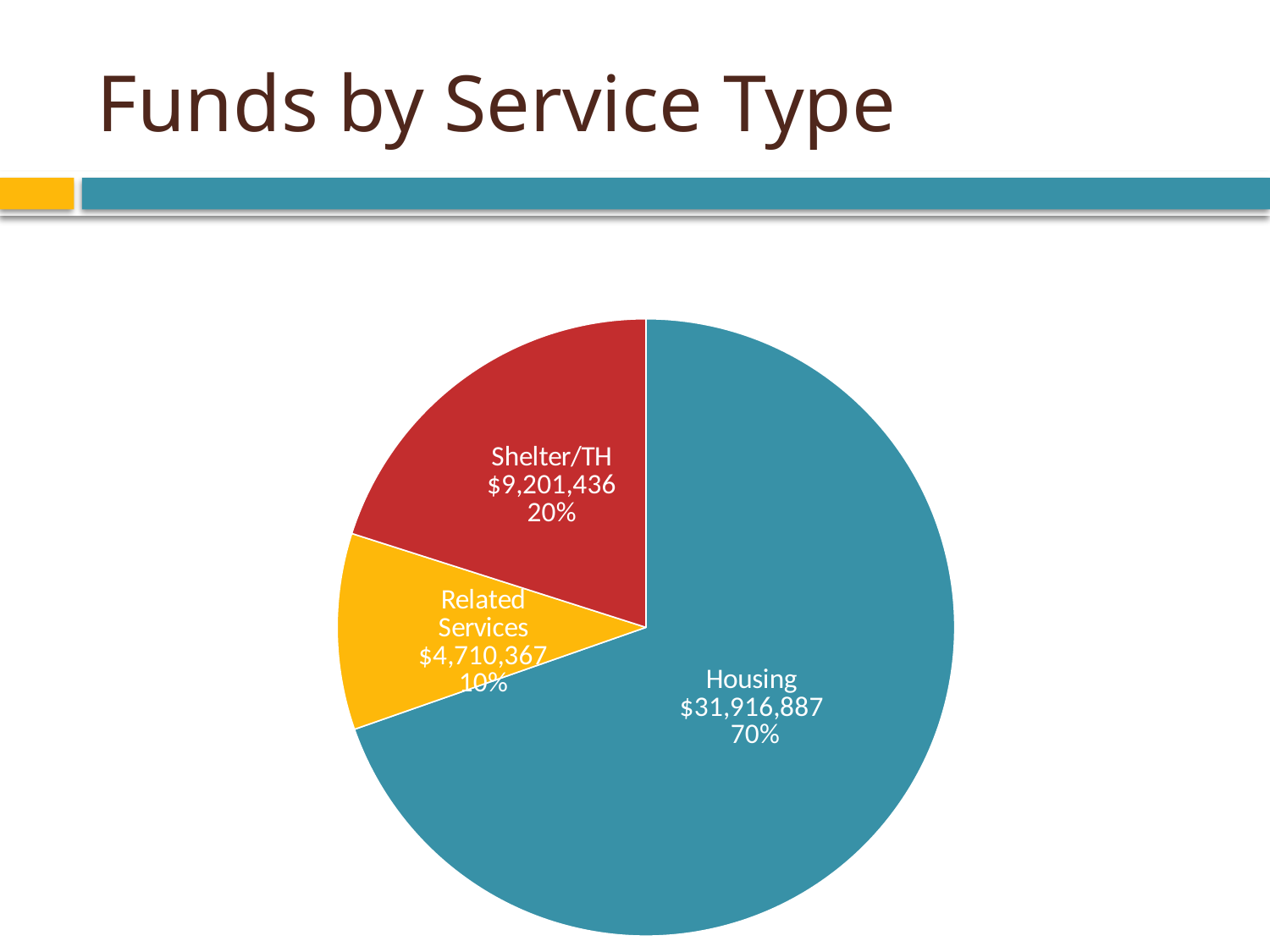
What share of the pie does Shelter/TH represent? 20% Which service type receives the least funds? Related Services Which service type receives the most funds? Housing What is the funding amount for Housing? $31,916,887 What share of the pie does Housing represent? 70% What is the funding amount for Related Services? $4,710,367 What is the difference in funds between Shelter/TH and Related Services? $4,491,069 What is the title of the slide? Funds by Service Type What is the funding amount for Shelter/TH? $9,201,436 How many service types are shown in the pie chart? 3 What type of chart is shown on the slide? pie chart What share of the pie does Related Services represent? 10%